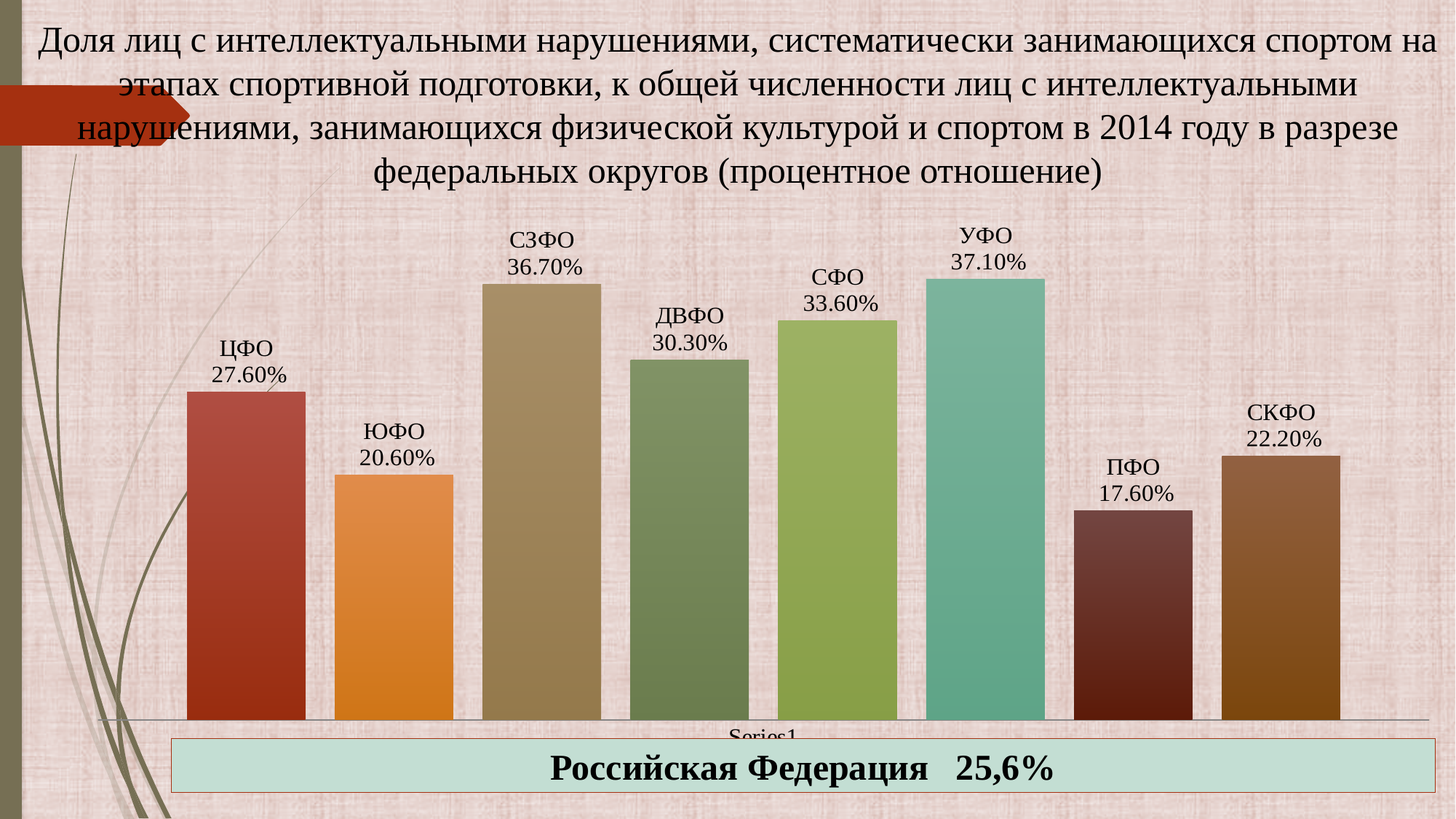
What kind of chart is shown on the slide? Bar chart What is the value for СФО? 33.60% What year does the chart title say the data refers to? 2014 What is the value for ПФО? 17.60% What value is given for Российская Федерация in the box below the chart? 25,6% What is the difference between the values for СЗФО and ЮФО? 16.10% Which federal district has the lowest value? ПФО Which is larger, the value for ДВФО or the value for ЦФО? ДВФО How many federal districts are shown as bars in the chart? 8 What is the value for ЦФО? 27.60% Which federal district has the highest value? УФО What is the difference between the values for СКФО and ПФО? 4.60%